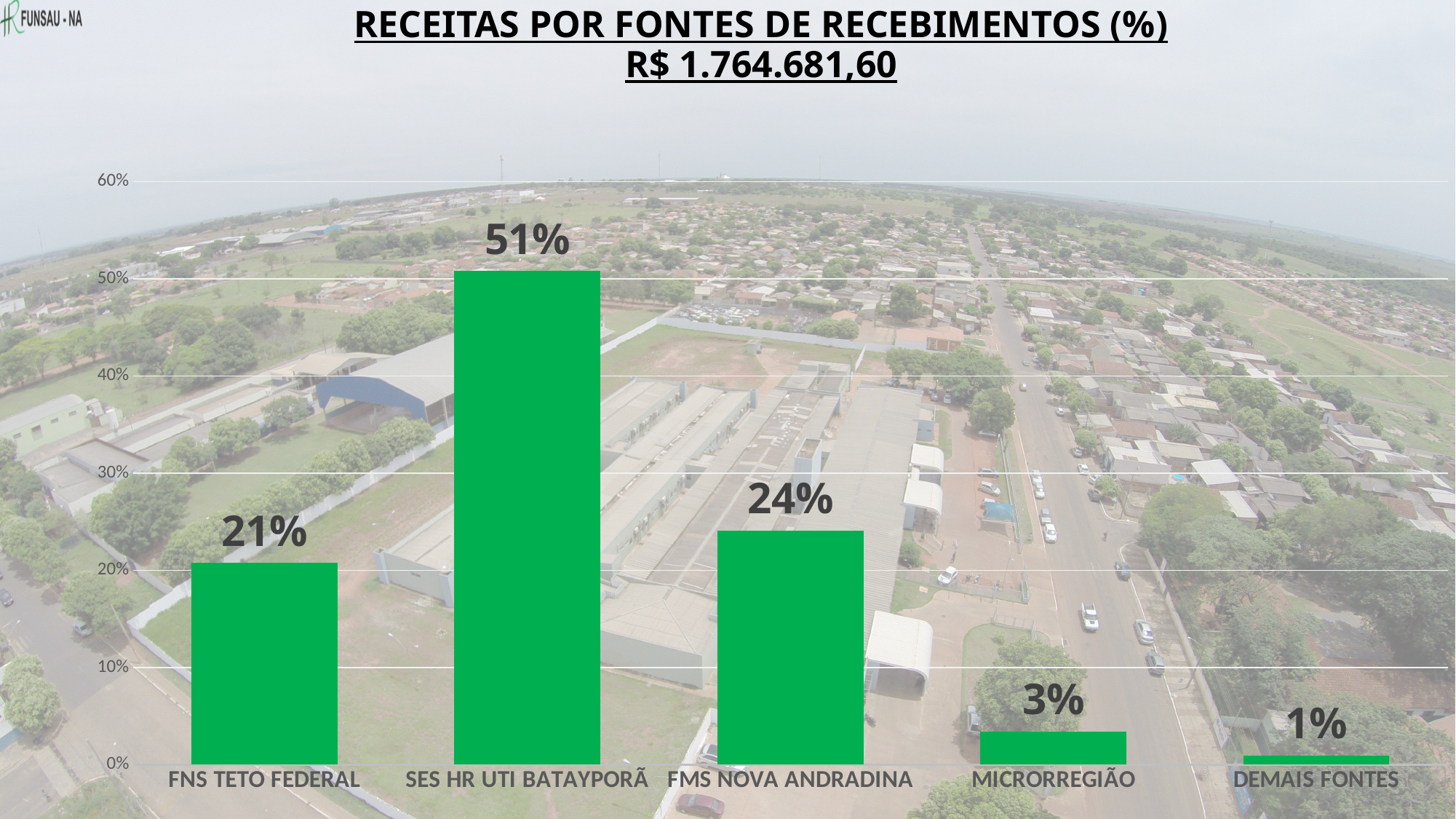
Which category has the lowest value? DEMAIS FONTES Which category has the highest value? SES HR UTI BATAYPORÃ What is the value for FMS NOVA ANDRADINA? 24% How many categories are shown in the chart? 5 What total amount in R$ is shown in the chart title? R$ 1.764.681,60 What kind of chart is shown on the slide? bar chart What is the value for FNS TETO FEDERAL? 21% What is the value for MICRORREGIÃO? 3% Which is larger, the value for FNS TETO FEDERAL or the value for FMS NOVA ANDRADINA? FMS NOVA ANDRADINA What is the difference between the values for SES HR UTI BATAYPORÃ and FMS NOVA ANDRADINA? 27% What is the value for DEMAIS FONTES? 1% What is the value for SES HR UTI BATAYPORÃ? 51%